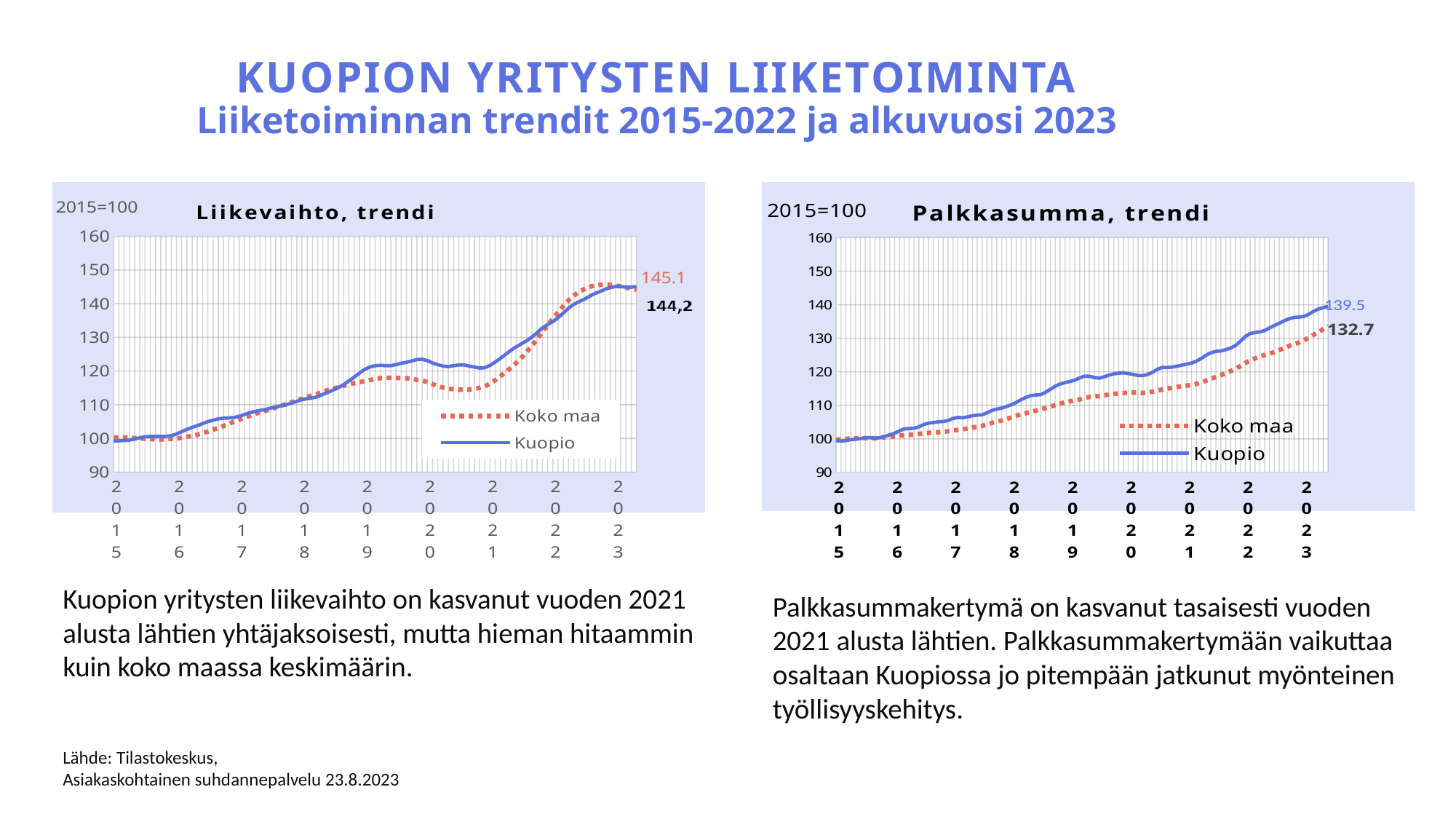
How many series does the legend of the 'Palkkasumma, trendi' chart list? 2 What kind of chart is 'Liikevaihto, trendi'? Line chart In the 'Liikevaihto, trendi' chart, what is the latest labelled value for Koko maa? 145.1 In the 'Liikevaihto, trendi' chart, is the Kuopio value in 2019 greater or less than 110? greater In the 'Palkkasumma, trendi' chart, what is the difference between the final labelled values of Kuopio and Koko maa? 6.8 In the 'Liikevaihto, trendi' chart, what is the latest labelled value for Kuopio? 144,2 In the 'Palkkasumma, trendi' chart, what is the latest labelled value for Kuopio? 139.5 In the 'Liikevaihto, trendi' chart, what is the difference between the final labelled values of Koko maa and Kuopio? 0.9 In the 'Palkkasumma, trendi' chart, does the Kuopio line generally rise or fall from 2015 to 2023? Rise What base index is shown in the top-left corner of both charts? 2015=100 In the 'Palkkasumma, trendi' chart, what is the latest labelled value for Koko maa? 132.7 In the 'Palkkasumma, trendi' chart, which series has the higher final labelled value, Kuopio or Koko maa? Kuopio